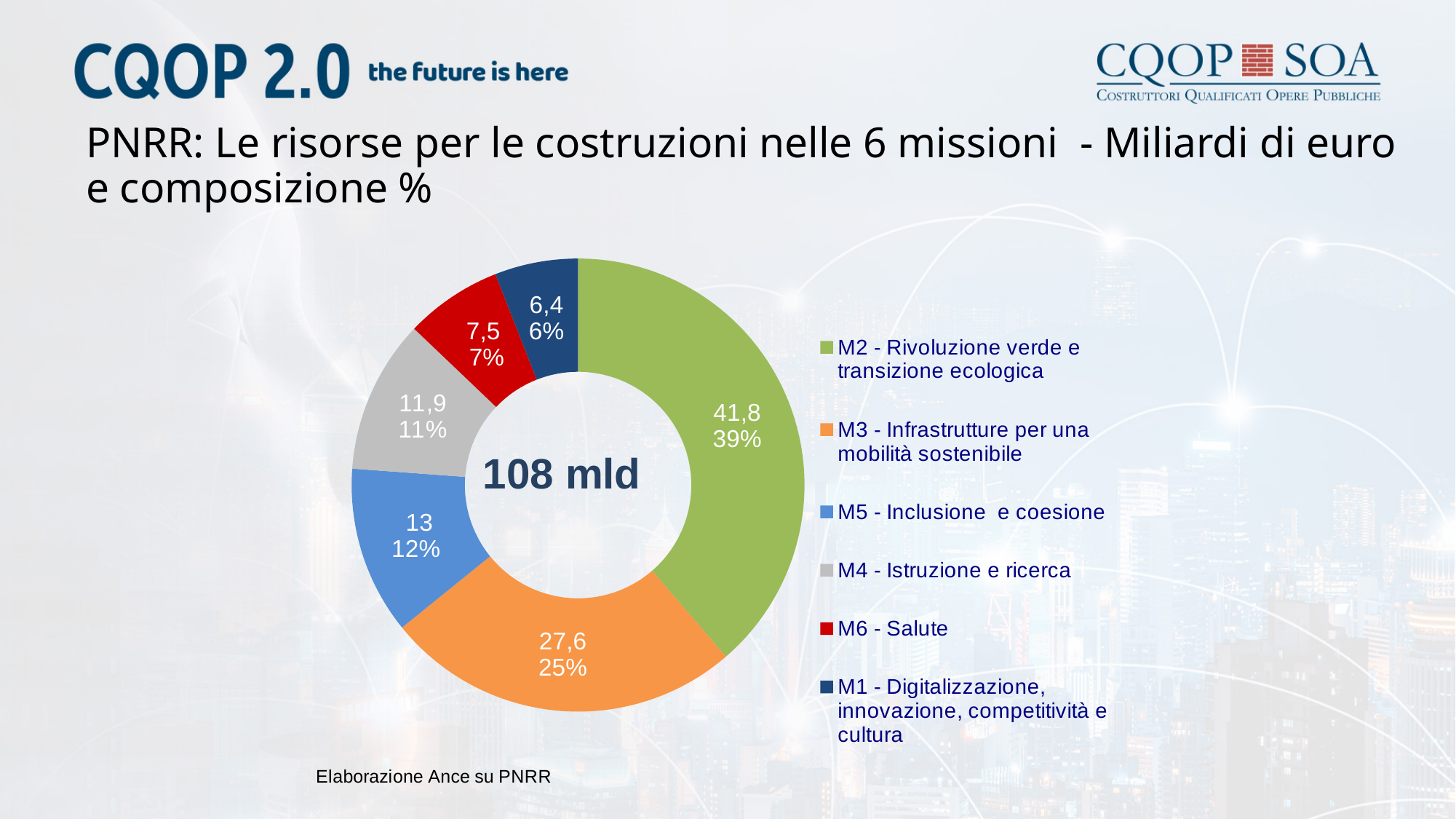
What percentage share is shown for M1 - Digitalizzazione, innovazione, competitività e cultura? 6% What is the difference in billions of euro between M2 - Rivoluzione verde e transizione ecologica and M3 - Infrastrutture per una mobilità sostenibile? 14,2 What value in billions of euro is shown for M6 - Salute? 7,5 What total is printed in the centre of the chart? 108 mld What value in billions of euro is shown for M5 - Inclusione e coesione? 13 Which mission has the largest slice of the chart? M2 - Rivoluzione verde e transizione ecologica What percentage share is shown for M3 - Infrastrutture per una mobilità sostenibile? 25% What percentage share is shown for M4 - Istruzione e ricerca? 11% What value in billions of euro is shown for M2 - Rivoluzione verde e transizione ecologica? 41,8 Which is larger, the value for M5 - Inclusione e coesione or the value for M4 - Istruzione e ricerca? M5 - Inclusione e coesione Which mission has the smallest slice of the chart? M1 - Digitalizzazione, innovazione, competitività e cultura How many missions (slices) does the chart show? 6